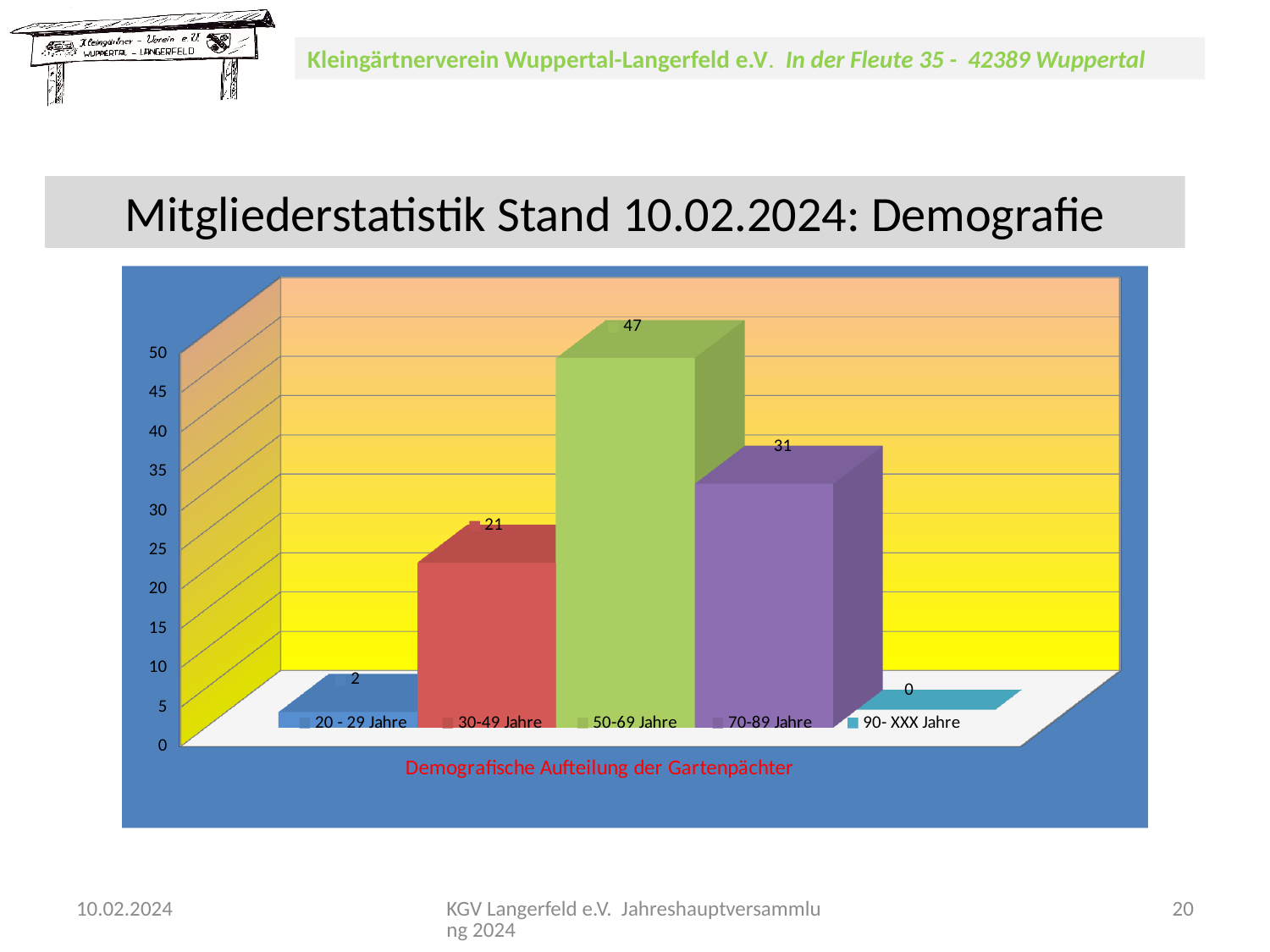
What is the value for 70-89 Jahre? 31 Which age group has the highest value? 50-69 Jahre What is the title shown below the chart's bars? Demografische Aufteilung der Gartenpächter How many age groups are shown in the chart? 5 What is the value for 20 - 29 Jahre? 2 Which is larger, the value for 30-49 Jahre or the value for 70-89 Jahre? 70-89 Jahre What is the difference between the values for 50-69 Jahre and 70-89 Jahre? 16 What kind of chart is shown on the slide? bar chart Which age group has the lowest value? 90- XXX Jahre What is the value for 50-69 Jahre? 47 What is the value for 90- XXX Jahre? 0 What is the value for 30-49 Jahre? 21